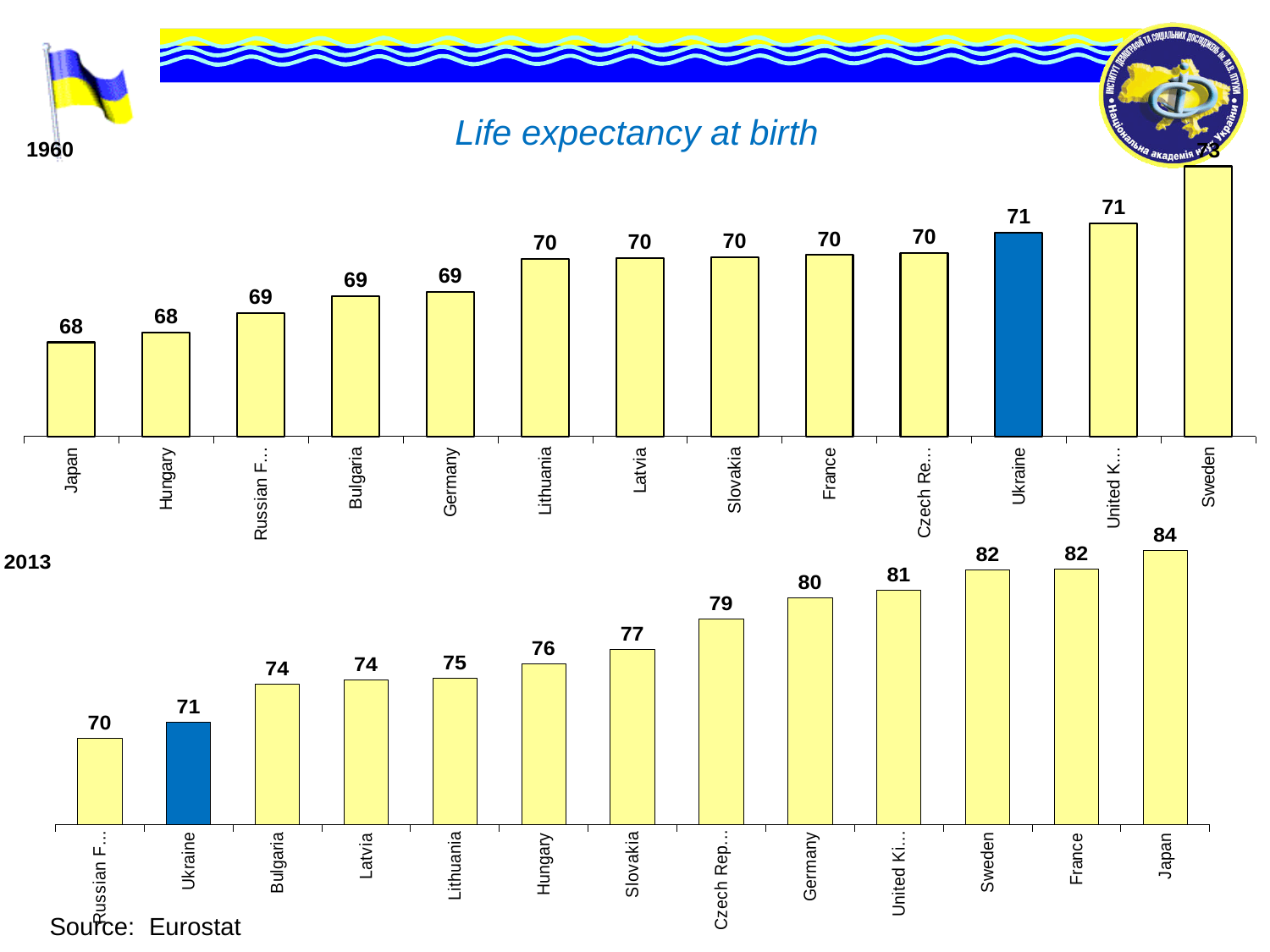
In the 1960 chart, what is the difference between the values for Ukraine and Japan? 3 In the 1960 chart, which country has the lowest life expectancy? Japan and Hungary (both 68) In the 2013 chart, which is larger, the value for Germany or the value for Slovakia? Germany In the 2013 chart, which country has the lowest life expectancy? Russian Federation In the 2013 chart, what is the value shown for Ukraine? 71 In the 2013 chart, what is the life expectancy value shown for Japan? 84 In the 1960 chart, what is the life expectancy value shown for Ukraine? 71 How many countries are shown in the 2013 chart? 13 In the 2013 chart, what is the difference between the values for Japan and Ukraine? 13 What type of chart is used for the 1960 data? Bar chart In the 2013 chart, which country has the highest life expectancy? Japan In the 2013 chart, do the values rise or fall from left to right? Rise